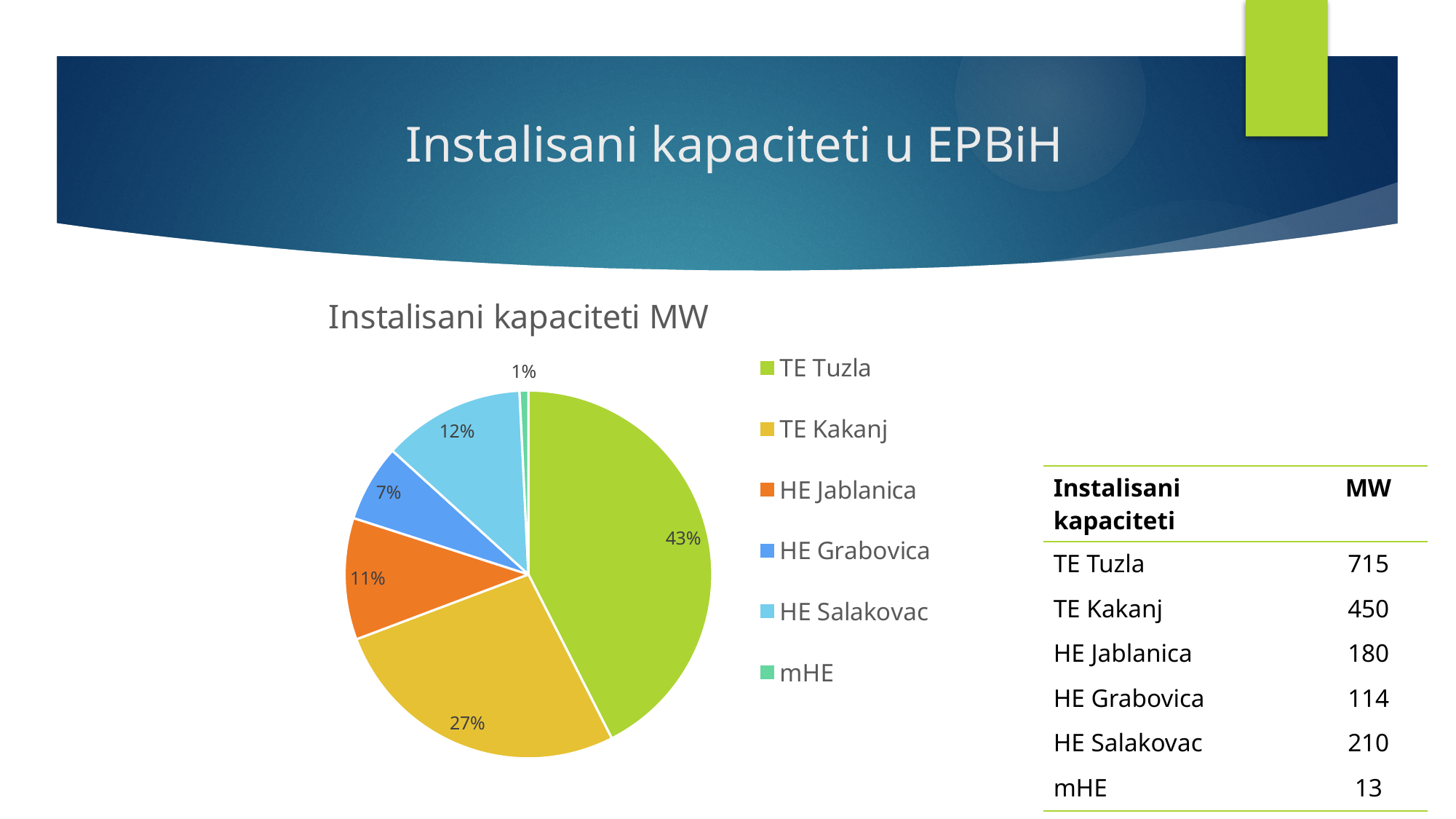
Which category has the largest slice of the pie? TE Tuzla What is the difference in percentage points between the TE Tuzla and TE Kakanj slices? 16% What share of the pie does HE Salakovac represent? 12% How many slices does the pie chart have? 6 What share of the pie does HE Grabovica represent? 7% What share of the pie does TE Kakanj represent? 27% Which slice is larger, HE Jablanica or HE Salakovac? HE Salakovac What type of chart is shown on the slide? pie chart What is the title of the chart? Instalisani kapaciteti MW Which category has the smallest slice of the pie? mHE How many entries does the chart legend list? 6